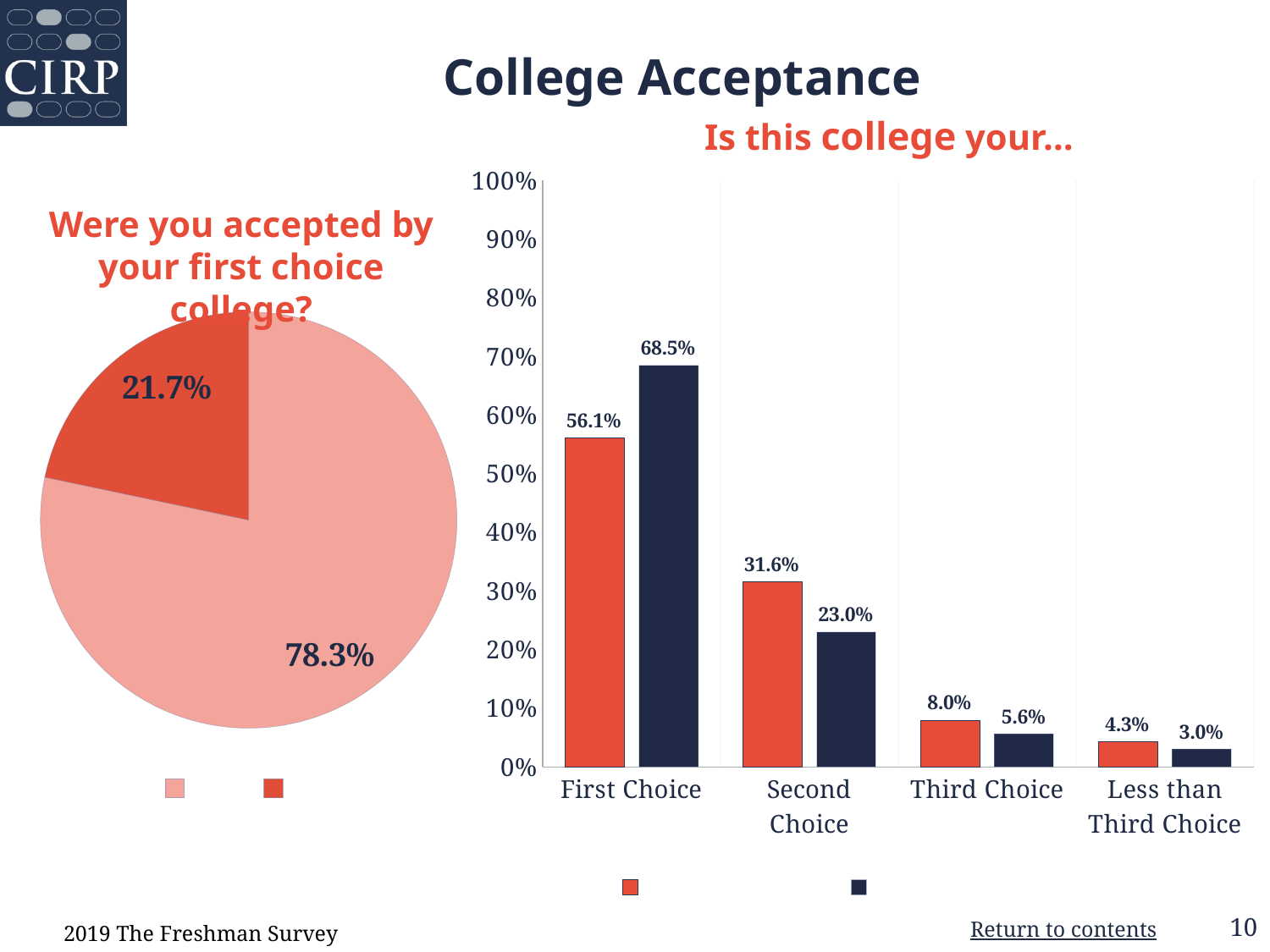
In the bar chart 'Is this college your...', do the red bars rise or fall from First Choice to Less than Third Choice? fall How many categories are shown on the x axis of the bar chart 'Is this college your...'? 4 How many series does the legend of the bar chart 'Is this college your...' list? 2 In the pie chart 'Were you accepted by your first choice college?', what share does the larger, light pink slice represent? 78.3% In the bar chart 'Is this college your...', what is the difference between the dark navy bar and the red bar for First Choice? 12.4% What kind of chart is the chart on the left titled 'Were you accepted by your first choice college?'? pie chart In the bar chart 'Is this college your...', what is the value of the red bar for Less than Third Choice? 4.3% In the bar chart 'Is this college your...', which is larger for Third Choice: the red bar or the dark navy bar? the red bar In the bar chart 'Is this college your...', which category has the lowest red bar? Less than Third Choice In the bar chart 'Is this college your...', what is the value of the dark navy bar for Second Choice? 23.0% In the bar chart 'Is this college your...', what is the value of the red bar for First Choice? 56.1% In the bar chart 'Is this college your...', which category has the highest dark navy bar? First Choice